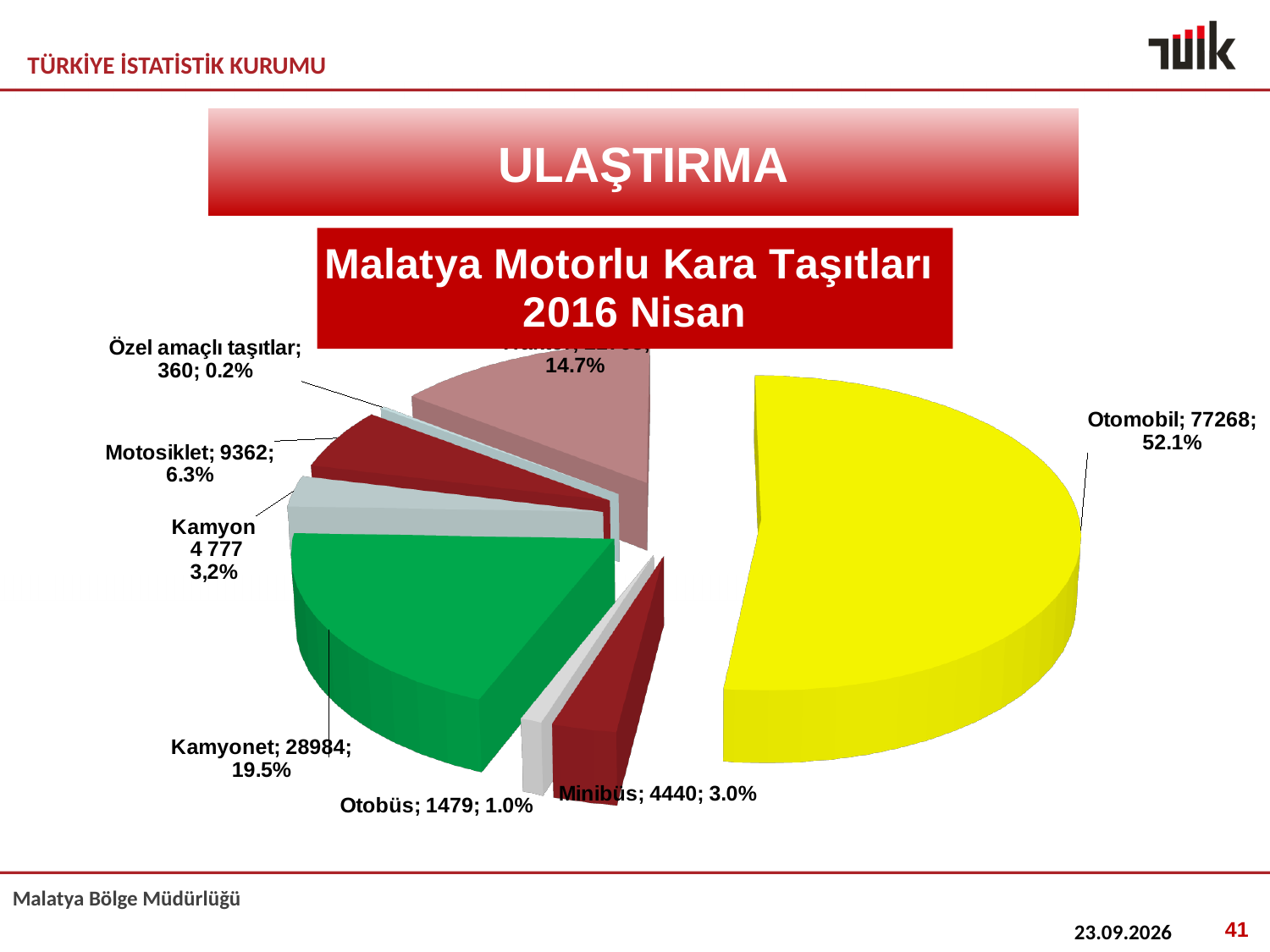
What is the value shown for Kamyonet? 28984 Which category has the smallest slice of the pie? Özel amaçlı taşıtlar What is the value shown for Kamyon? 4 777 What is the difference between the values for Kamyonet and Motosiklet? 19622 Which category has the largest slice of the pie? Otomobil What is the value shown for Otomobil? 77268 What share of the pie does Otobüs represent? 1.0% What share of the pie does Otomobil represent? 52.1% Which is larger, the value for Motosiklet or the value for Minibüs? Motosiklet How many slices does the pie chart have? 8 What kind of chart is shown on the slide? pie chart What is the title of the chart? Malatya Motorlu Kara Taşıtları 2016 Nisan